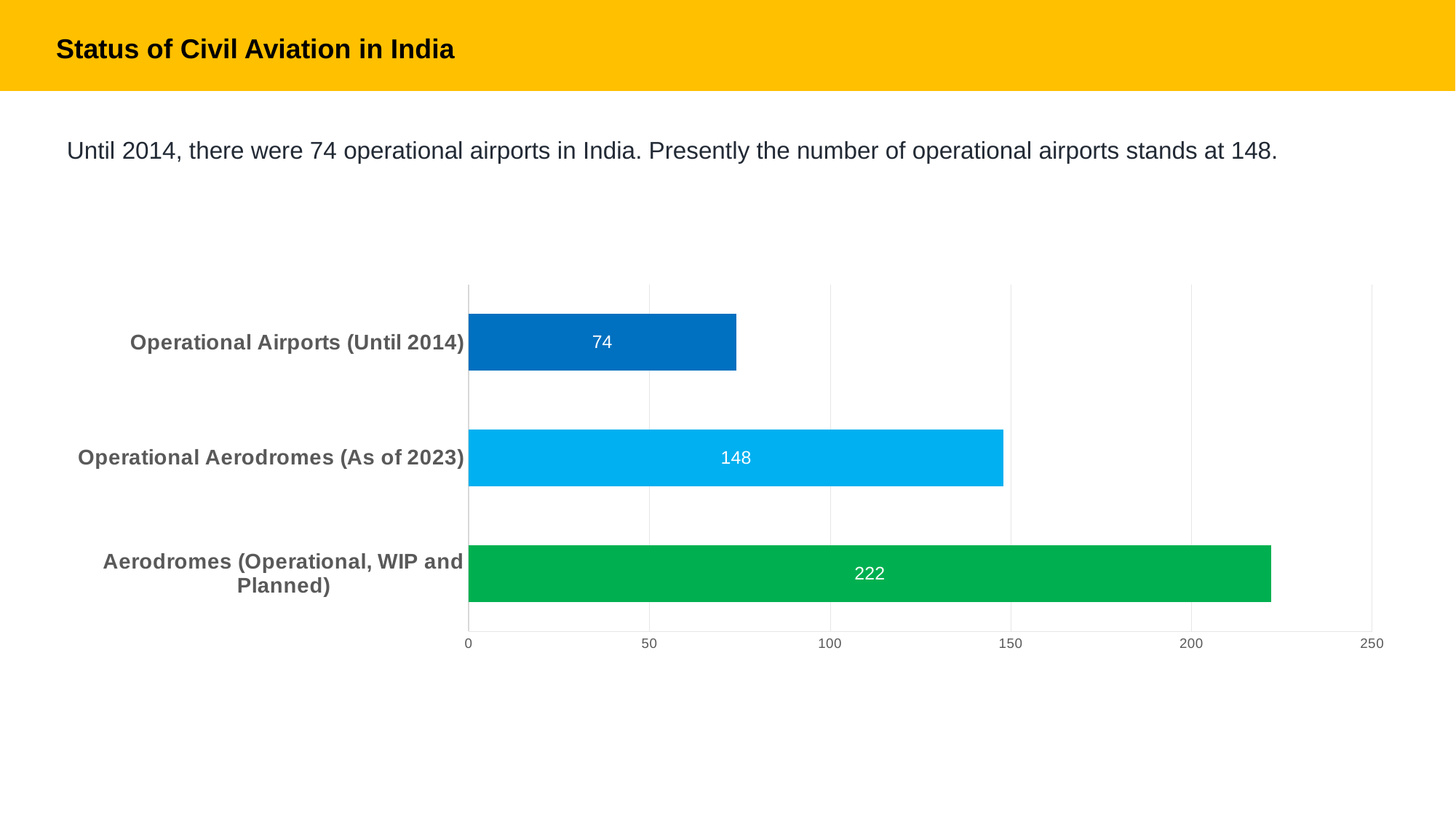
What is the difference between the value for Operational Aerodromes (As of 2023) and the value for Operational Airports (Until 2014)? 74 What is the value for Aerodromes (Operational, WIP and Planned)? 222 Which is larger: the value for Operational Airports (Until 2014) or the value for Operational Aerodromes (As of 2023)? Operational Aerodromes (As of 2023) What is the difference between the value for Aerodromes (Operational, WIP and Planned) and the value for Operational Aerodromes (As of 2023)? 74 Is the value for Aerodromes (Operational, WIP and Planned) greater or less than 200? greater Which category has the lowest value? Operational Airports (Until 2014) Which category has the highest value? Aerodromes (Operational, WIP and Planned) What kind of chart is shown on the slide? bar chart What is the value for Operational Airports (Until 2014)? 74 What is the highest value shown on the horizontal axis of the chart? 250 What is the value for Operational Aerodromes (As of 2023)? 148 How many categories are shown in the chart? 3